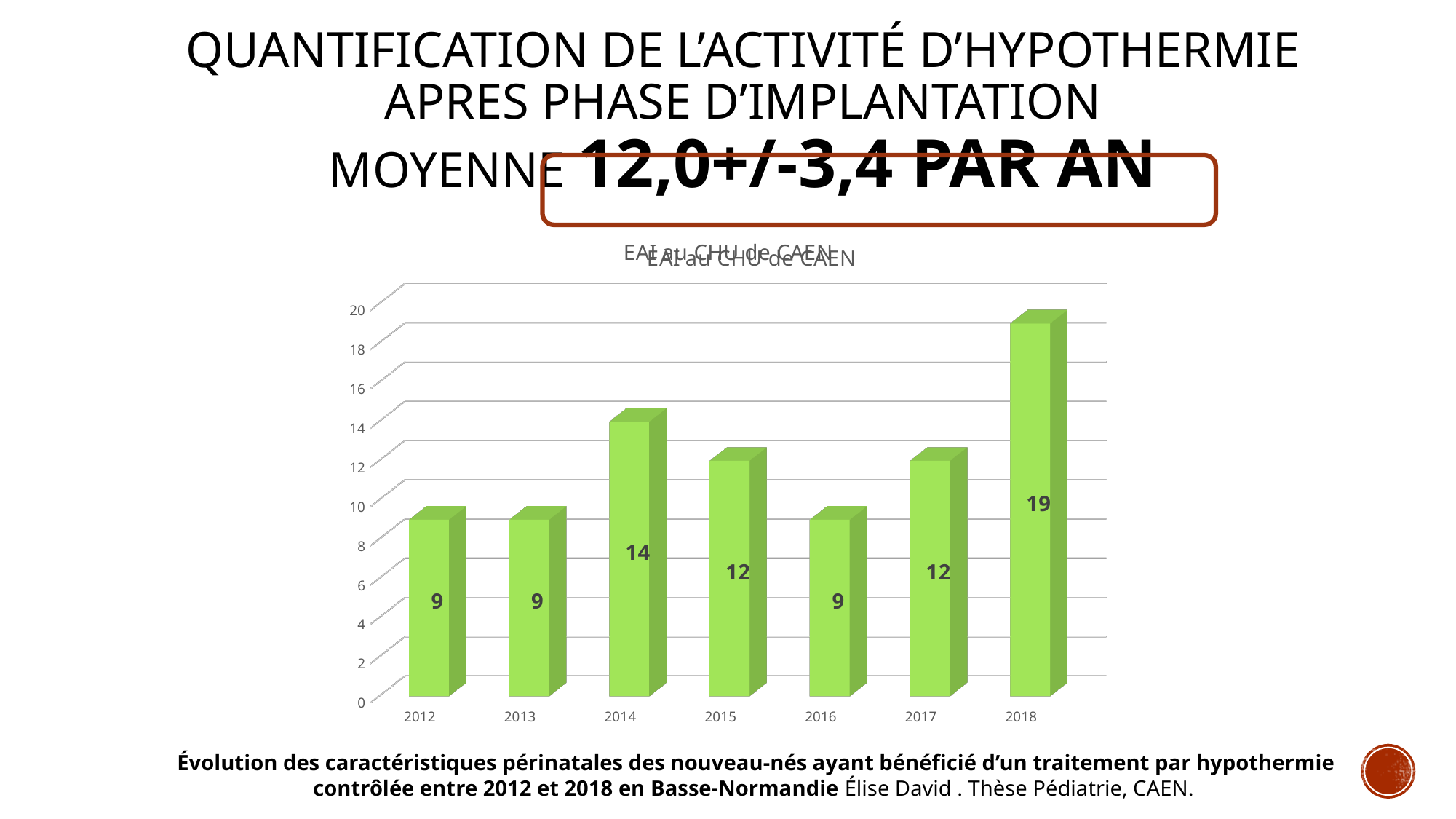
What is the title of the chart? EAI au CHU de CAEN How many years are shown on the x axis? 7 What is the difference between the values for 2015 and 2012? 3 Is the value for 2018 greater or less than 16? greater What is the value for 2018? 19 What is the value for 2014? 14 What is the value for 2016? 9 What kind of chart is shown on the slide? bar chart Which is larger, the value for 2014 or the value for 2017? 2014 Does the value rise or fall from 2017 to 2018? rise Which year has the highest value? 2018 What is the difference between the values for 2018 and 2014? 5